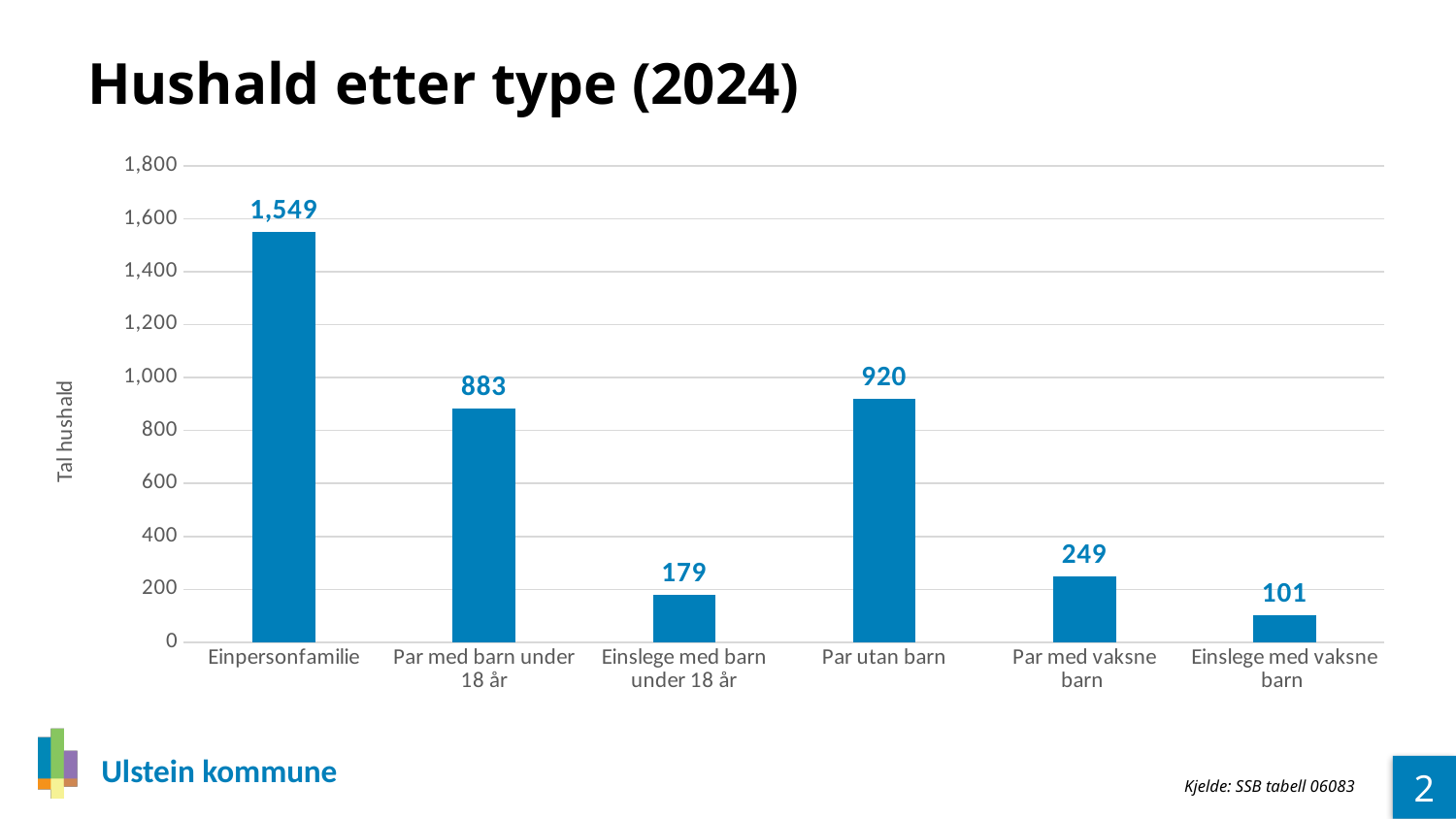
Which is larger, Par med vaksne barn or Einslege med barn under 18 år? Par med vaksne barn What is the title of the chart? Hushald etter type (2024) What is the value for Par utan barn? 920 How many categories are shown on the chart? 6 What is the difference between Par utan barn and Par med barn under 18 år? 37 Which category has the lowest value? Einslege med vaksne barn Is the value for Par med barn under 18 år greater or less than 1,000? less What kind of chart is shown on the slide? bar chart What is the difference between Par med vaksne barn and Einslege med barn under 18 år? 70 Which category has the highest value? Einpersonfamilie What is the value for Einpersonfamilie? 1,549 What is the value for Einslege med vaksne barn? 101